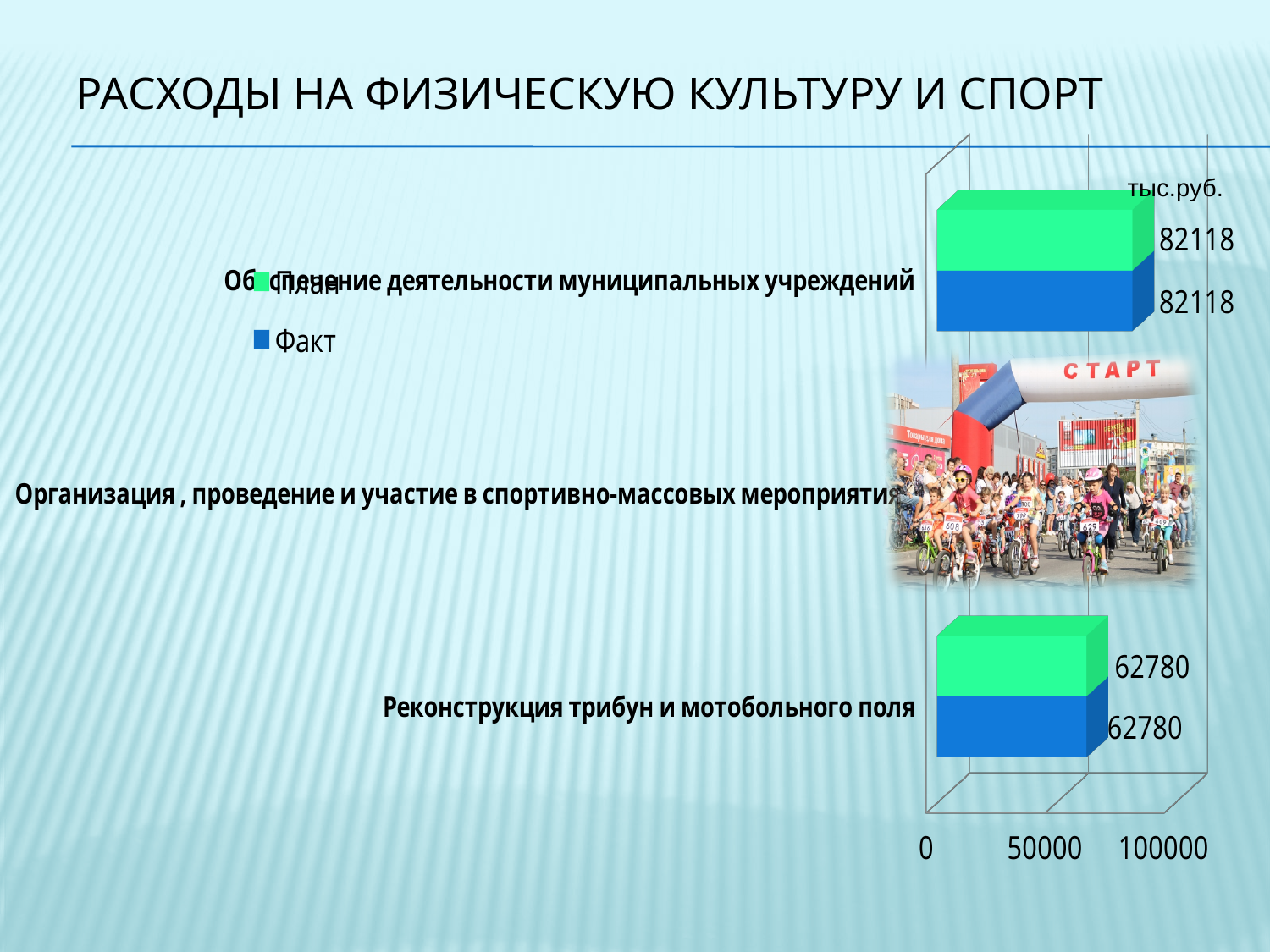
Is the План value for Обеспечение деятельности муниципальных учреждений greater or less than 100000? less Is the Факт value for Реконструкция трибун и мотобольного поля greater or less than 50000? greater What is the difference between the План values for Обеспечение деятельности муниципальных учреждений and Реконструкция трибун и мотобольного поля? 19338 What is the Факт value for Реконструкция трибун и мотобольного поля? 62780 What kind of chart is shown on the slide? bar chart How many series does the legend list? 2 What is the Факт value for Обеспечение деятельности муниципальных учреждений? 82118 What unit is indicated for the values in the chart? тыс.руб. What is the План value for Обеспечение деятельности муниципальных учреждений? 82118 Which has the larger Факт value: Обеспечение деятельности муниципальных учреждений or Реконструкция трибун и мотобольного поля? Обеспечение деятельности муниципальных учреждений What is the План value for Реконструкция трибун и мотобольного поля? 62780 What is the difference between the План and Факт values for Реконструкция трибун и мотобольного поля? 0